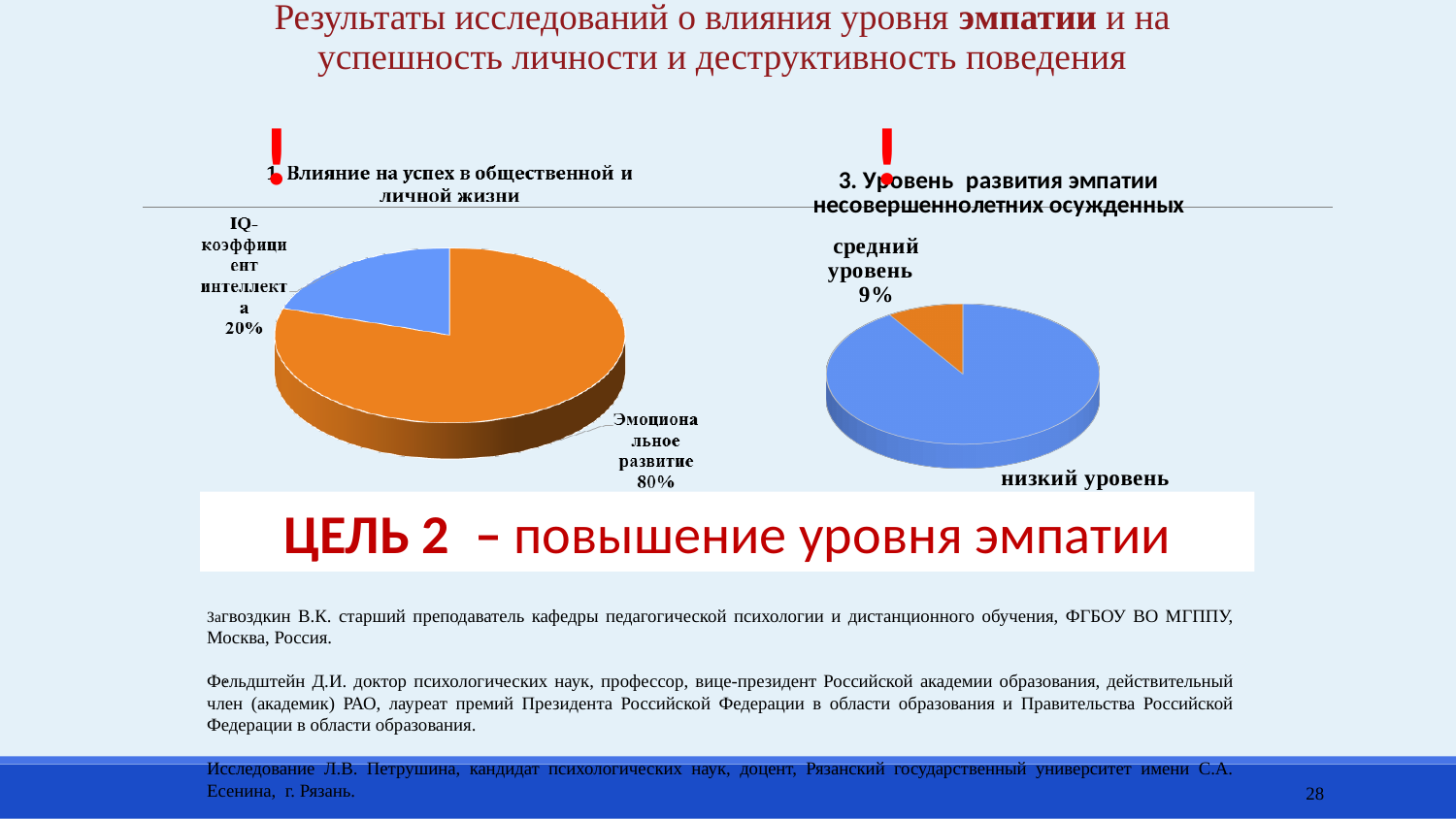
What type of chart is the left chart "Влияние на успех в общественной и личной жизни"? Pie chart In the right chart "Уровень развития эмпатии несовершеннолетних осужденных", what share is shown for "средний уровень"? 9% In the left chart "Влияние на успех в общественной и личной жизни", what share is shown for "Эмоциональное развитие"? 80% In the left chart "Влияние на успех в общественной и личной жизни", which slice is the smallest? IQ-коэффициент интеллекта In the right chart "Уровень развития эмпатии несовершеннолетних осужденных", which is larger: "средний уровень" or "низкий уровень"? низкий уровень In the left chart "Влияние на успех в общественной и личной жизни", what share is shown for "IQ-коэффициент интеллекта"? 20% In the left chart "Влияние на успех в общественной и личной жизни", how many slices does the pie have? 2 What type of chart is the right chart "Уровень развития эмпатии несовершеннолетних осужденных"? Pie chart In the left chart "Влияние на успех в общественной и личной жизни", what is the difference in percentage points between "Эмоциональное развитие" and "IQ-коэффициент интеллекта"? 60 percentage points In the right chart "Уровень развития эмпатии несовершеннолетних осужденных", which slice is the largest? низкий уровень In the right chart "Уровень развития эмпатии несовершеннолетних осужденных", how many slices does the pie have? 2 In the left chart "Влияние на успех в общественной и личной жизни", which slice is the largest? Эмоциональное развитие